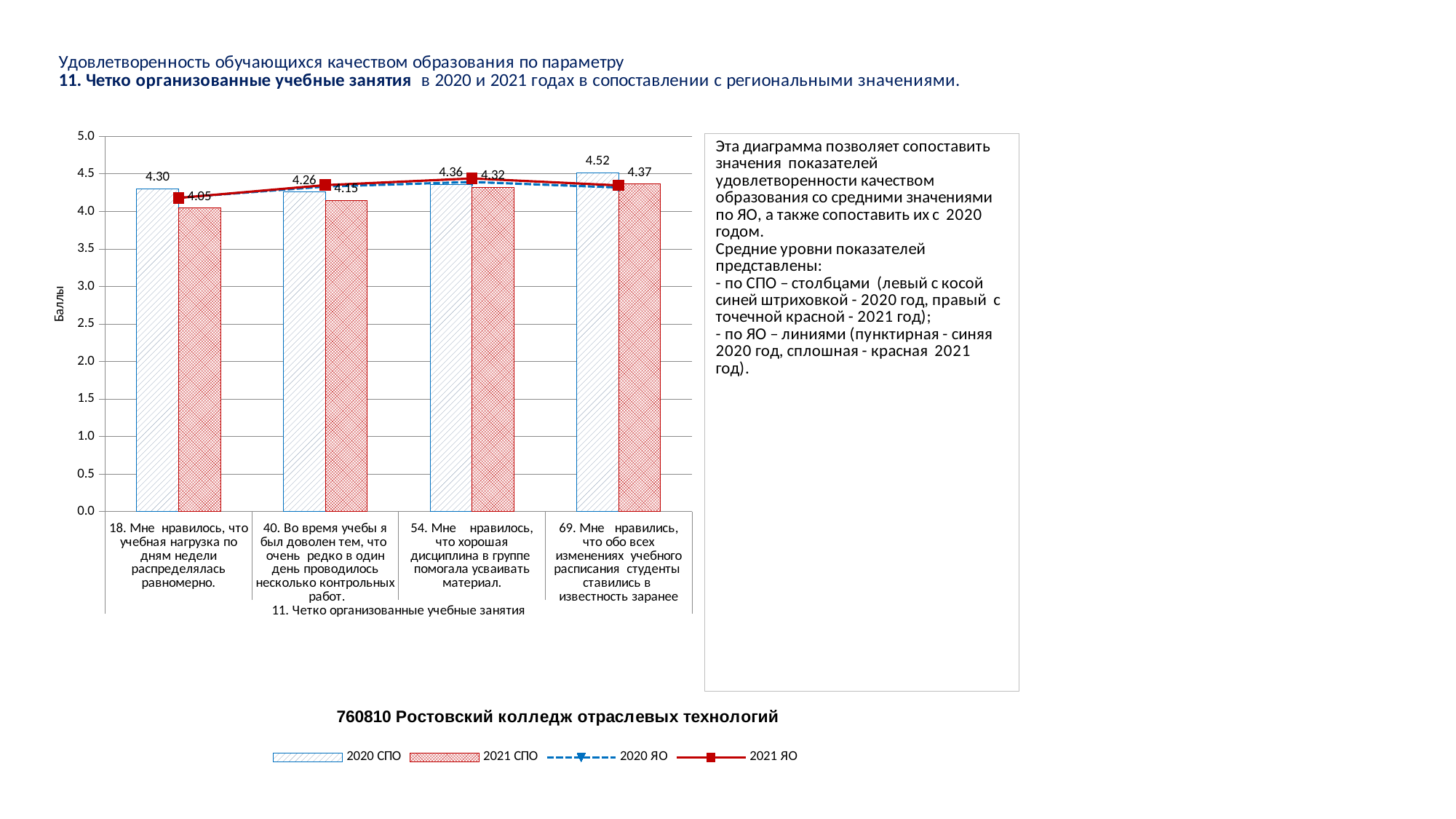
What is the 2020 СПО value for category 18 (Мне нравилось, что учебная нагрузка по дням недели распределялась равномерно)? 4.30 Is the 2021 СПО value for category 18 greater or less than 4.5? less For category 54, which is larger: the 2020 СПО value or the 2021 СПО value? 2020 СПО What is the 2021 СПО value for category 69 (Мне нравились, что обо всех изменениях учебного расписания студенты ставились в известность заранее)? 4.37 What is the 2021 СПО value for category 40 (Во время учебы я был доволен тем, что очень редко в один день проводилось несколько контрольных работ)? 4.15 Which category has the lowest 2021 СПО value? 18. Мне нравилось, что учебная нагрузка по дням недели распределялась равномерно. How many categories are shown on the x axis? 4 Which category has the highest 2020 СПО value? 69. Мне нравились, что обо всех изменениях учебного расписания студенты ставились в известность заранее What kind of chart is shown on the slide? Combined bar and line chart How many series does the legend list? 4 What is the label of the y axis? Баллы What is the difference between the 2020 СПО and 2021 СПО values for category 18? 0.25